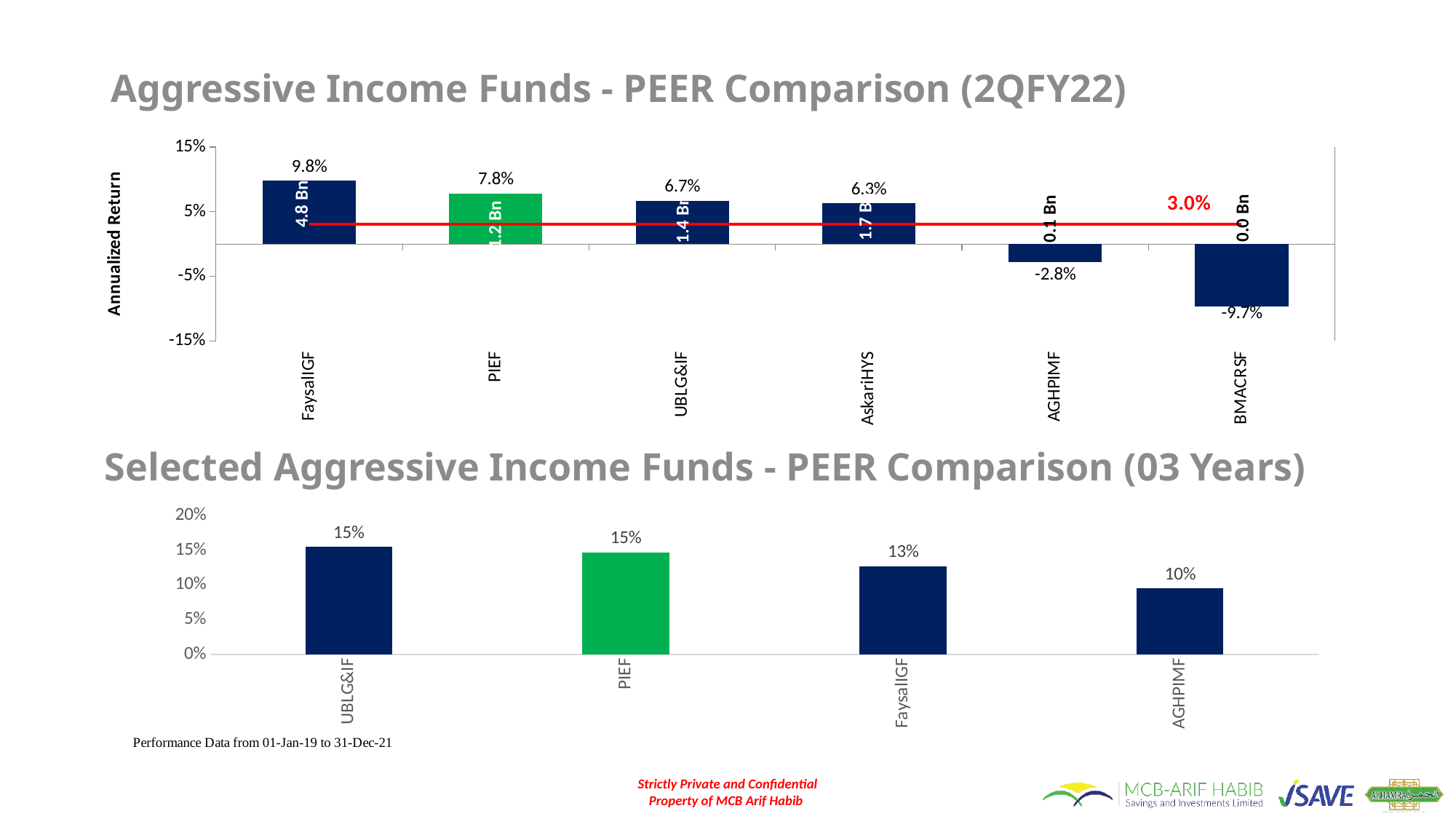
In the 'Aggressive Income Funds - PEER Comparison (2QFY22)' chart, what value is labelled on the red horizontal line? 3.0% In the 'Aggressive Income Funds - PEER Comparison (2QFY22)' chart, which fund has the highest annualized return? FaysalIGF In the 'Aggressive Income Funds - PEER Comparison (2QFY22)' chart, what is the annualized return for FaysalIGF? 9.8% In the 'Aggressive Income Funds - PEER Comparison (2QFY22)' chart, what is the annualized return for PIEF? 7.8% What kind of chart is the 'Selected Aggressive Income Funds - PEER Comparison (03 Years)' chart? Bar chart In the 'Aggressive Income Funds - PEER Comparison (2QFY22)' chart, what is the annualized return for AGHPIMF? -2.8% In the 'Aggressive Income Funds - PEER Comparison (2QFY22)' chart, which fund has the lowest annualized return? BMACRSF In the 'Selected Aggressive Income Funds - PEER Comparison (03 Years)' chart, which fund has the lowest value? AGHPIMF In the 'Selected Aggressive Income Funds - PEER Comparison (03 Years)' chart, what is the value for FaysalIGF? 13% In the 'Aggressive Income Funds - PEER Comparison (2QFY22)' chart, how many funds are shown? 6 In the 'Selected Aggressive Income Funds - PEER Comparison (03 Years)' chart, how many funds are shown? 4 In the 'Aggressive Income Funds - PEER Comparison (2QFY22)' chart, what is the difference between the returns of FaysalIGF and PIEF? 2.0%